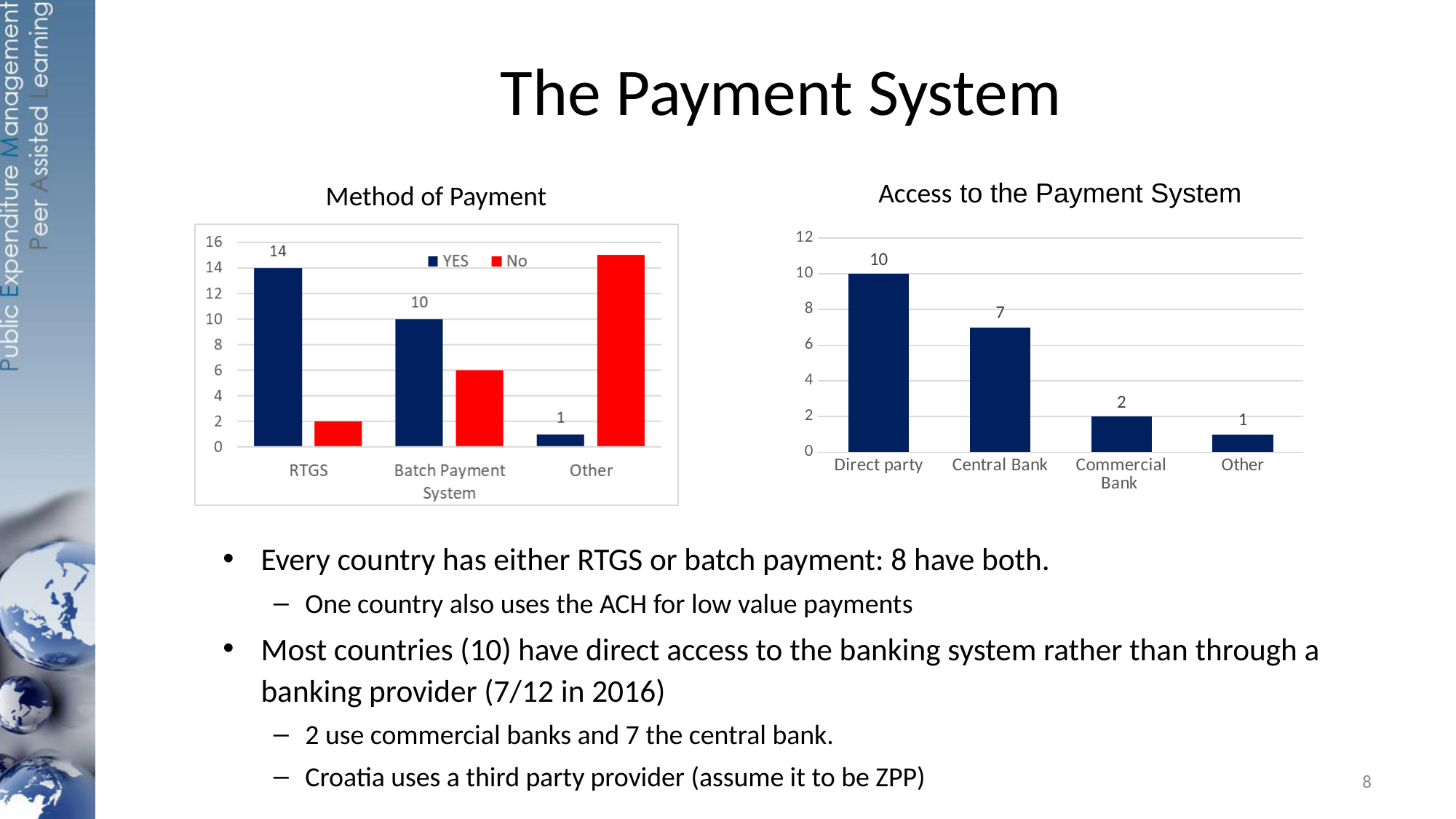
In the Method of Payment chart, which category has the lowest YES value? Other In the Method of Payment chart, what is the difference between the YES values for RTGS and Batch Payment System? 4 In the Access to the Payment System chart, what is the value for Central Bank? 7 In the Method of Payment chart, is the No value for RTGS greater or less than 4? less How many categories are shown in the Access to the Payment System chart? 4 How many series does the legend of the Method of Payment chart list? 2 In the Access to the Payment System chart, which category has the highest value? Direct party In the Method of Payment chart, what is the YES value for Batch Payment System? 10 In the Method of Payment chart, what is the YES value for RTGS? 14 In the Access to the Payment System chart, what is the difference between the values for Direct party and Commercial Bank? 8 In the Access to the Payment System chart, do the values rise or fall from left to right? fall In the Method of Payment chart, is the No value for Other greater or less than 12? greater